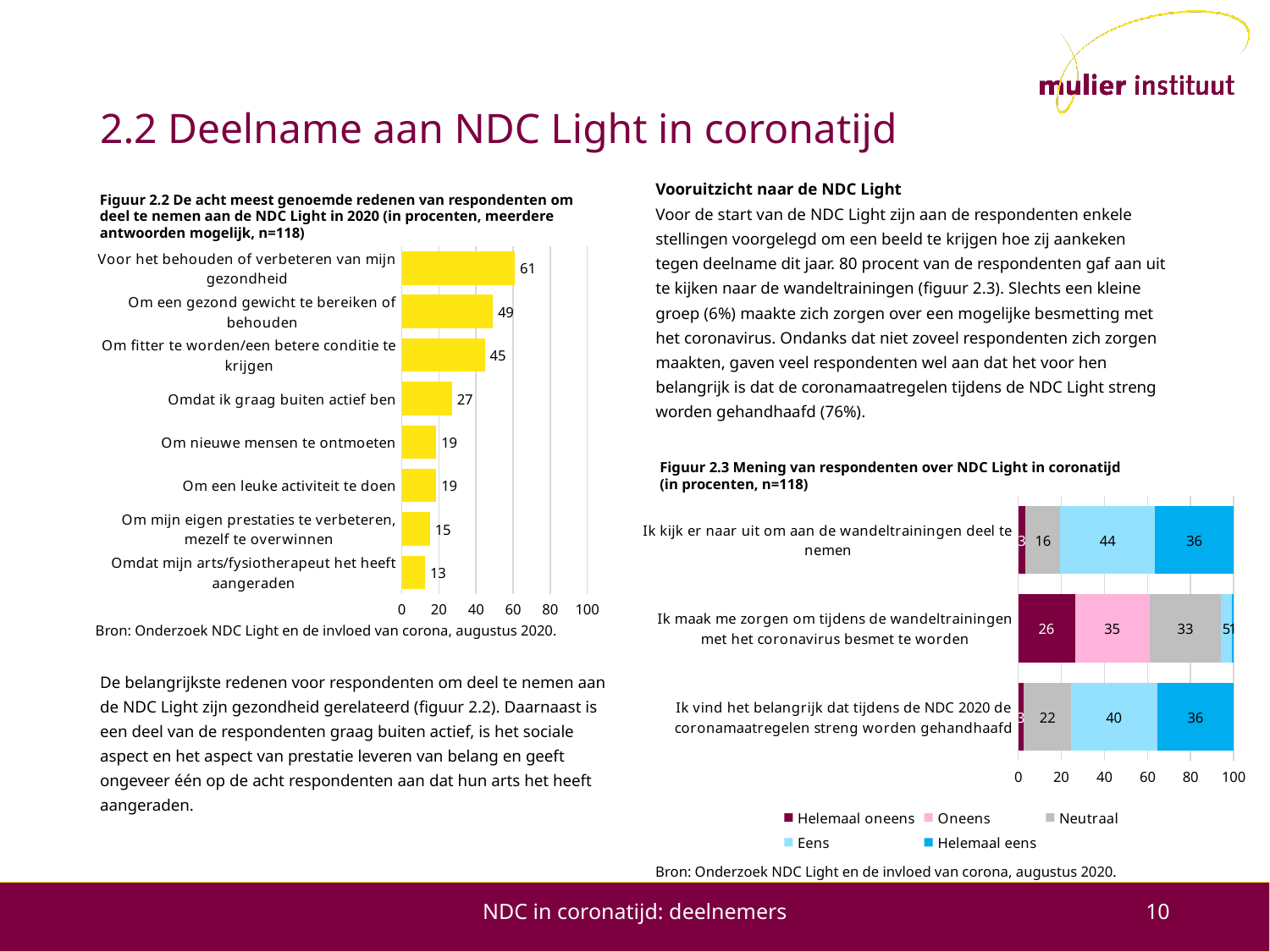
In Figuur 2.2, what percentage of respondents gave 'Voor het behouden of verbeteren van mijn gezondheid' as a reason? 61 In Figuur 2.2, how many reasons are shown? 8 In Figuur 2.2, what is the value for 'Omdat ik graag buiten actief ben'? 27 What type of chart is Figuur 2.2? Bar chart In Figuur 2.2, which reason has the highest percentage? Voor het behouden of verbeteren van mijn gezondheid In Figuur 2.2, which reason has the lowest percentage? Omdat mijn arts/fysiotherapeut het heeft aangeraden In Figuur 2.3, how many series does the legend list? 5 In Figuur 2.2, what is the difference between 'Om een gezond gewicht te bereiken of behouden' and 'Om fitter te worden/een betere conditie te krijgen'? 4 In Figuur 2.3, which is larger for 'Ik vind het belangrijk dat tijdens de NDC 2020 de coronamaatregelen streng worden gehandhaafd': 'Eens' or 'Neutraal'? Eens In Figuur 2.3, which colour represents 'Helemaal eens'? Blue In Figuur 2.3, what percentage answered 'Oneens' to 'Ik maak me zorgen om tijdens de wandeltrainingen met het coronavirus besmet te worden'? 35 In Figuur 2.3, what percentage answered 'Eens' to 'Ik kijk er naar uit om aan de wandeltrainingen deel te nemen'? 44